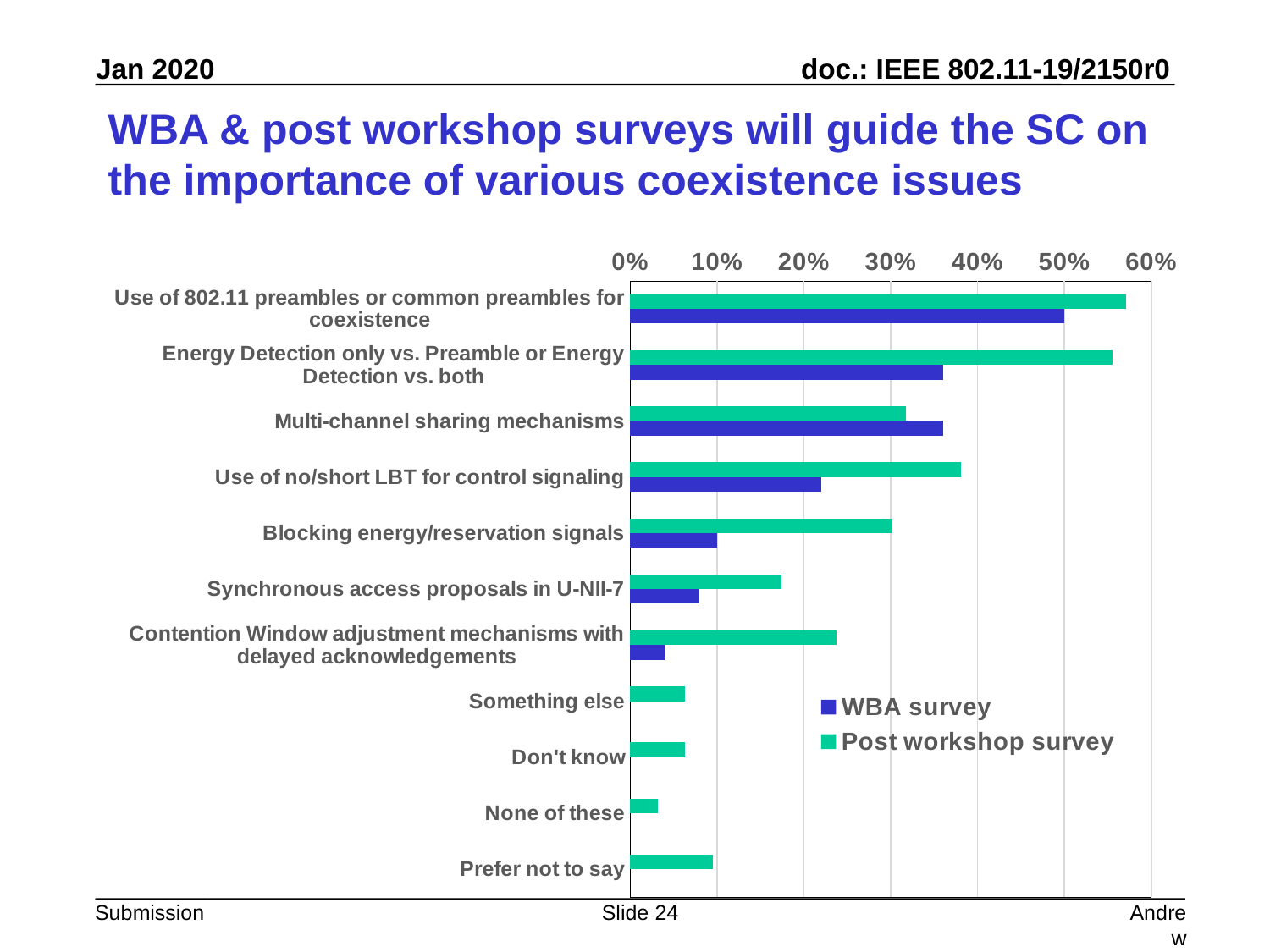
Is the Post workshop survey value for 'Use of 802.11 preambles or common preambles for coexistence' greater or less than 50%? greater For 'Multi-channel sharing mechanisms', which series has the larger value, WBA survey or Post workshop survey? WBA survey Which category has the highest value for the WBA survey series? Use of 802.11 preambles or common preambles for coexistence Is the Post workshop survey value for 'Contention Window adjustment mechanisms with delayed acknowledgements' greater or less than 20%? greater What kind of chart is shown on the slide? bar chart Which category has the lowest value for the Post workshop survey series? None of these Is the WBA survey value for 'Energy Detection only vs. Preamble or Energy Detection vs. both' greater or less than 30%? greater How many categories are plotted on the chart? 11 For 'Blocking energy/reservation signals', which series has the larger value, WBA survey or Post workshop survey? Post workshop survey Which colour represents the WBA survey series in the chart? blue How many series does the legend list? 2